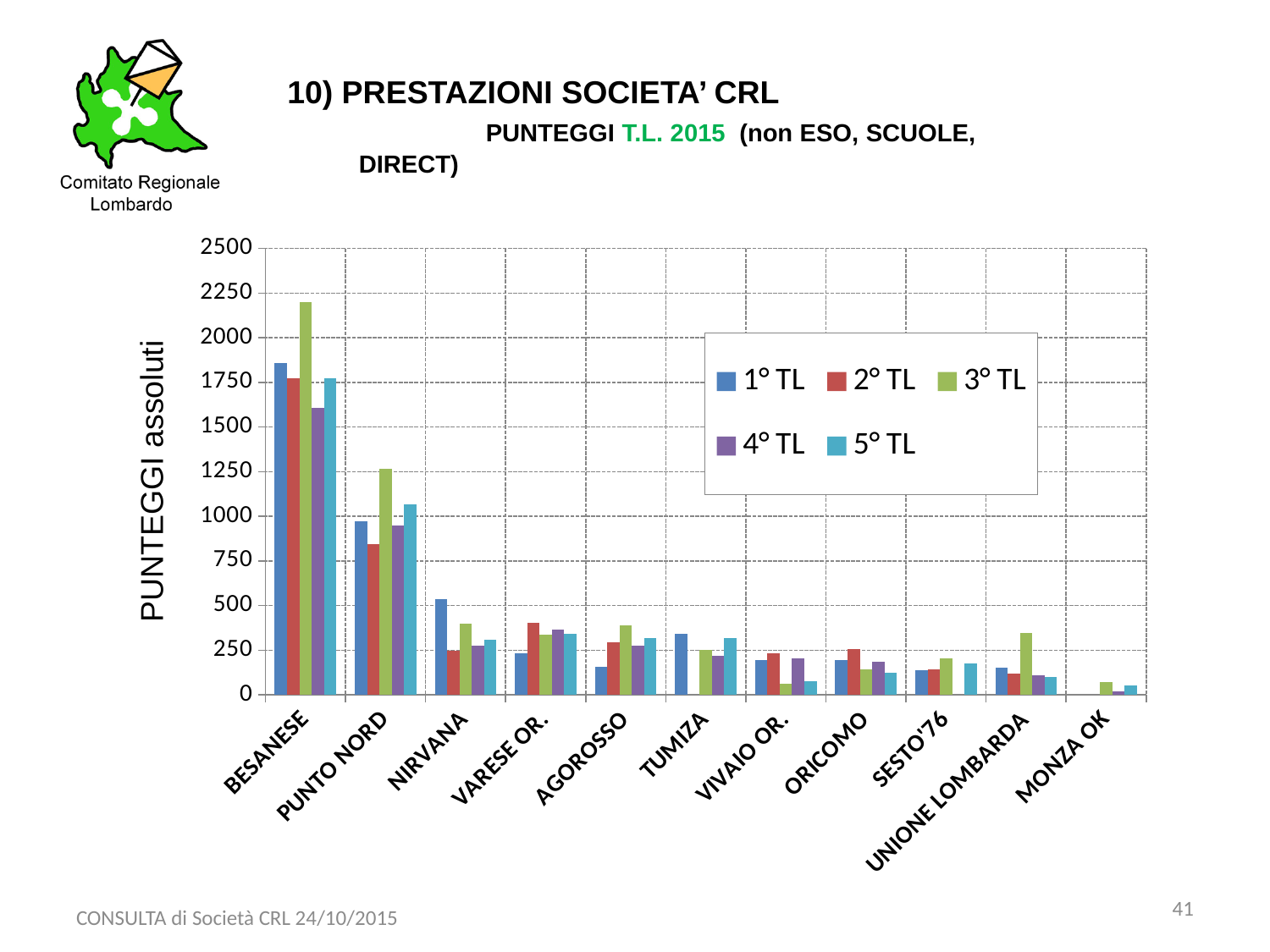
Which society has the lowest bars overall in the chart? MONZA OK How many series does the chart legend list? 5 What is the label of the y axis of the chart? PUNTEGGI assoluti How many societies (categories) are shown on the x axis of the chart? 11 What kind of chart is shown on the slide? bar chart Is the 2° TL value for PUNTO NORD greater or less than 1000? less For BESANESE, which is larger: the 1° TL value or the 3° TL value? 3° TL Is the 1° TL value for BESANESE greater or less than 1500? greater Is the 3° TL value for BESANESE greater or less than 2000? greater For PUNTO NORD, which is larger: the 3° TL value or the 5° TL value? 3° TL Which society has the highest bar in the chart? BESANESE